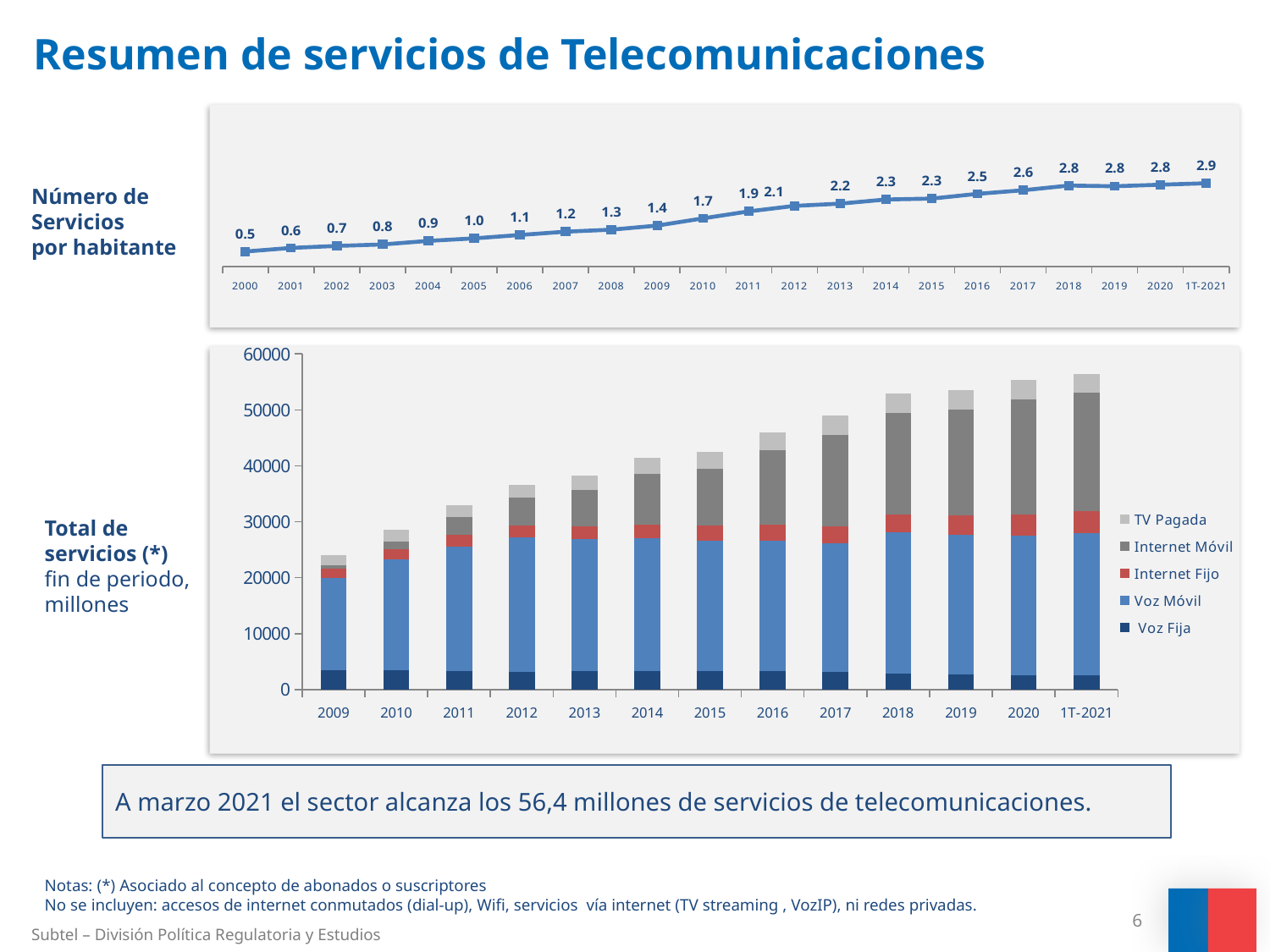
How many data points are plotted in the 'Número de Servicios por habitante' chart? 22 In the 'Número de Servicios por habitante' chart, which year has the lowest value? 2000 In the 'Número de Servicios por habitante' chart, which is larger, the value for 2012 or the value for 2008? 2012 How many series does the legend of the 'Total de servicios' chart list? 5 In the 'Número de Servicios por habitante' chart, what is the value for 1T-2021? 2.9 What kind of chart is the 'Total de servicios' chart? stacked bar chart In the 'Número de Servicios por habitante' chart, do the values generally rise or fall from 2000 to 1T-2021? rise In the 'Número de Servicios por habitante' chart, what is the value for 2000? 0.5 In the 'Total de servicios' chart, is the total bar height for 1T-2021 greater or less than 50000? greater In the 'Número de Servicios por habitante' chart, what is the difference between the values for 2020 and 2010? 1.1 In the 'Total de servicios' chart, is the total bar height for 2009 greater or less than 30000? less In the 'Número de Servicios por habitante' chart, what is the value for 2010? 1.7